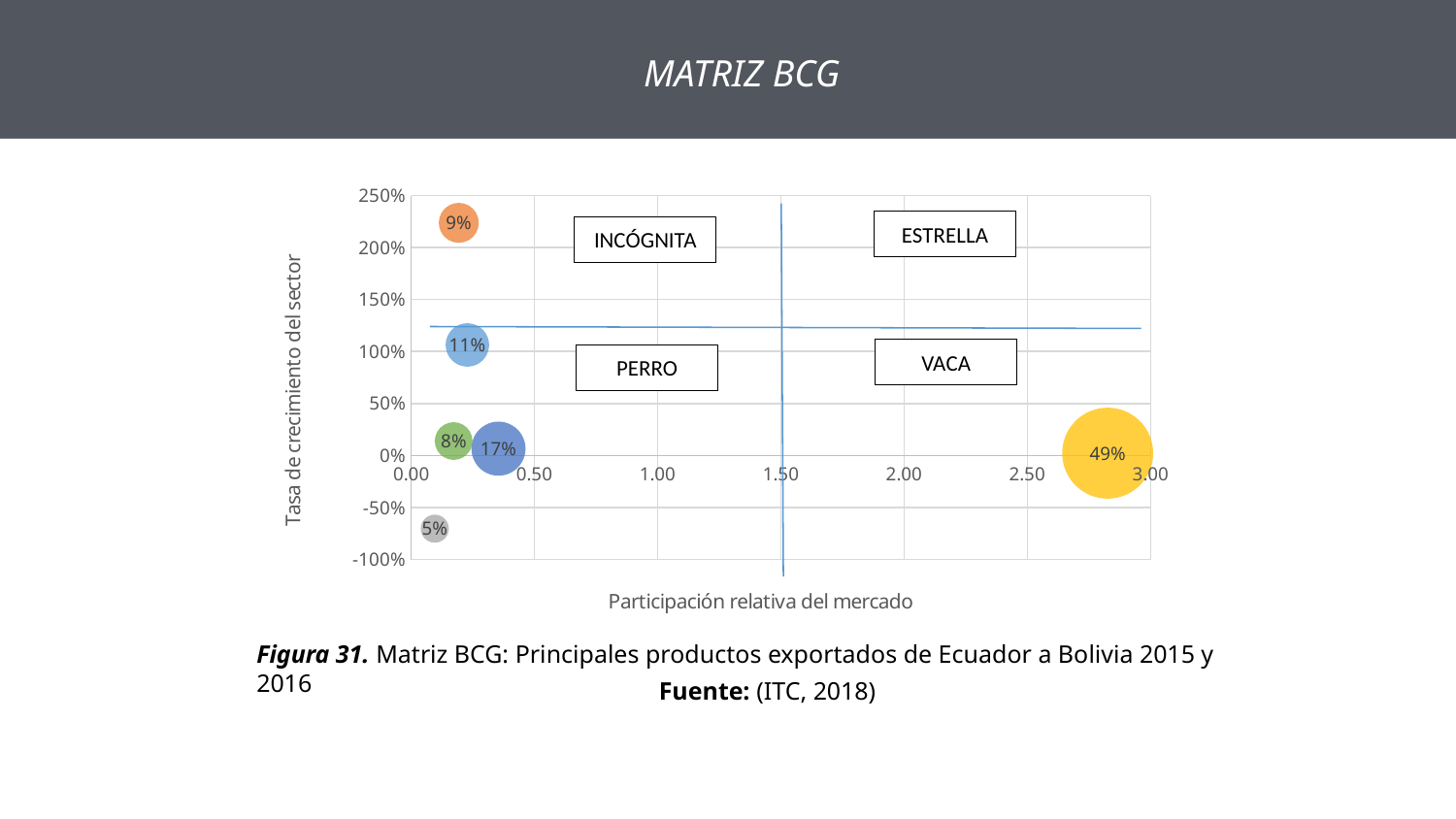
Is the relative market share (x-axis) of the 17% bubble greater or less than 1.00? less In which quadrant of the BCG matrix does the 49% bubble lie? VACA Is the sector growth rate (y-axis) of the 5% bubble greater or less than 0%? less What is the title of the x-axis? Participación relativa del mercado Which bubble has the smallest printed label value? 5% Is the relative market share (x-axis) of the 49% bubble greater or less than 2.50? greater What kind of chart is shown on the slide? bubble chart Which bubble label is larger, 17% or 11%? 17% How many bubbles are plotted on the chart? 6 What is the difference between the 49% bubble label and the 17% bubble label? 32% Which bubble has the largest printed label value? 49%